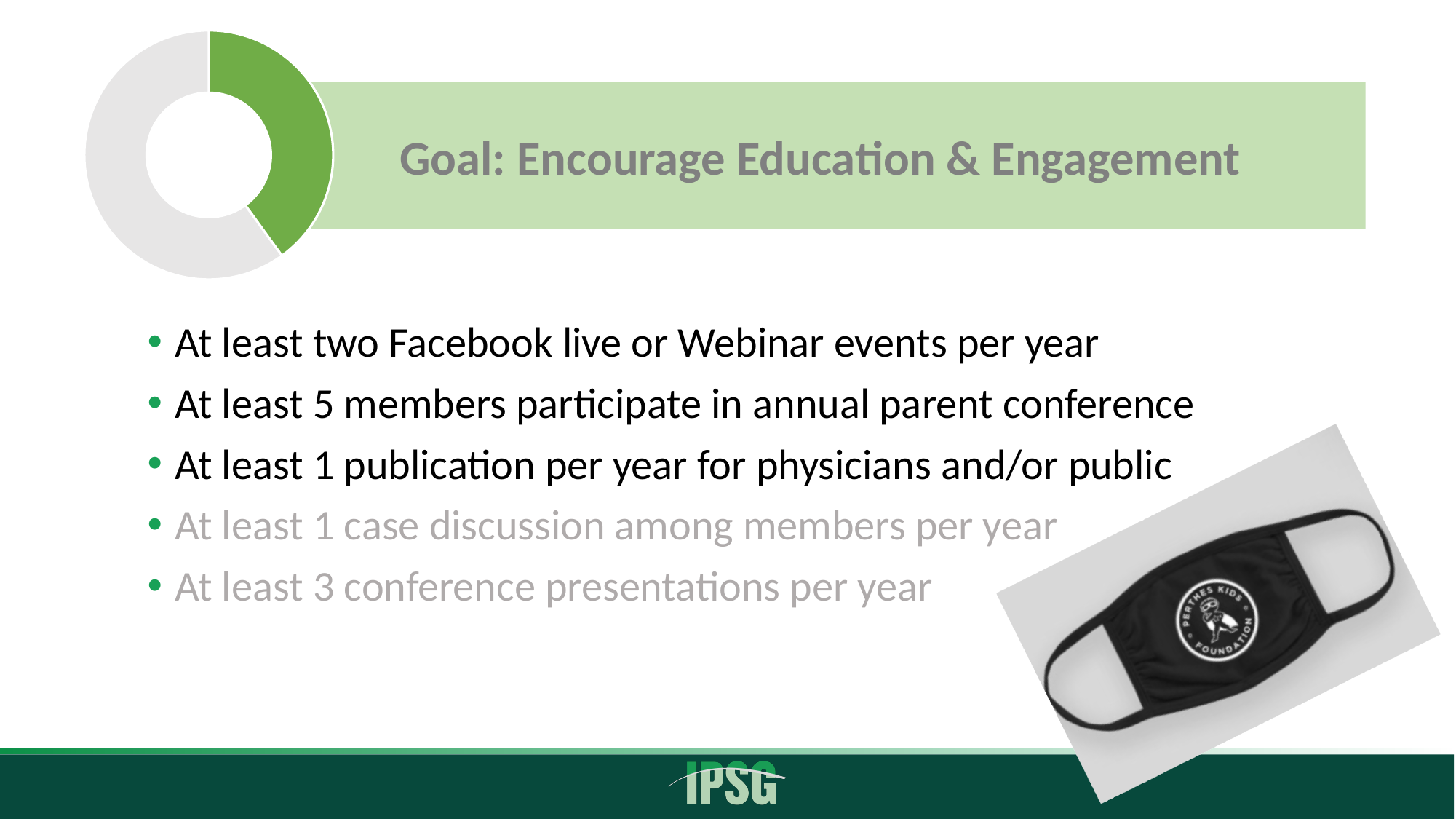
What kind of chart is shown at the top left of the slide? Donut (pie) chart What colour is the smaller segment of the donut chart at the top left of the slide? Green In the donut chart at the top left, is the green segment more or less than half of the ring? Less How many segments does the donut chart at the top left of the slide have? 2 Does the donut chart at the top left of the slide show any data labels or a legend? No In the donut chart at the top left, which segment is larger, the green one or the grey one? The grey one